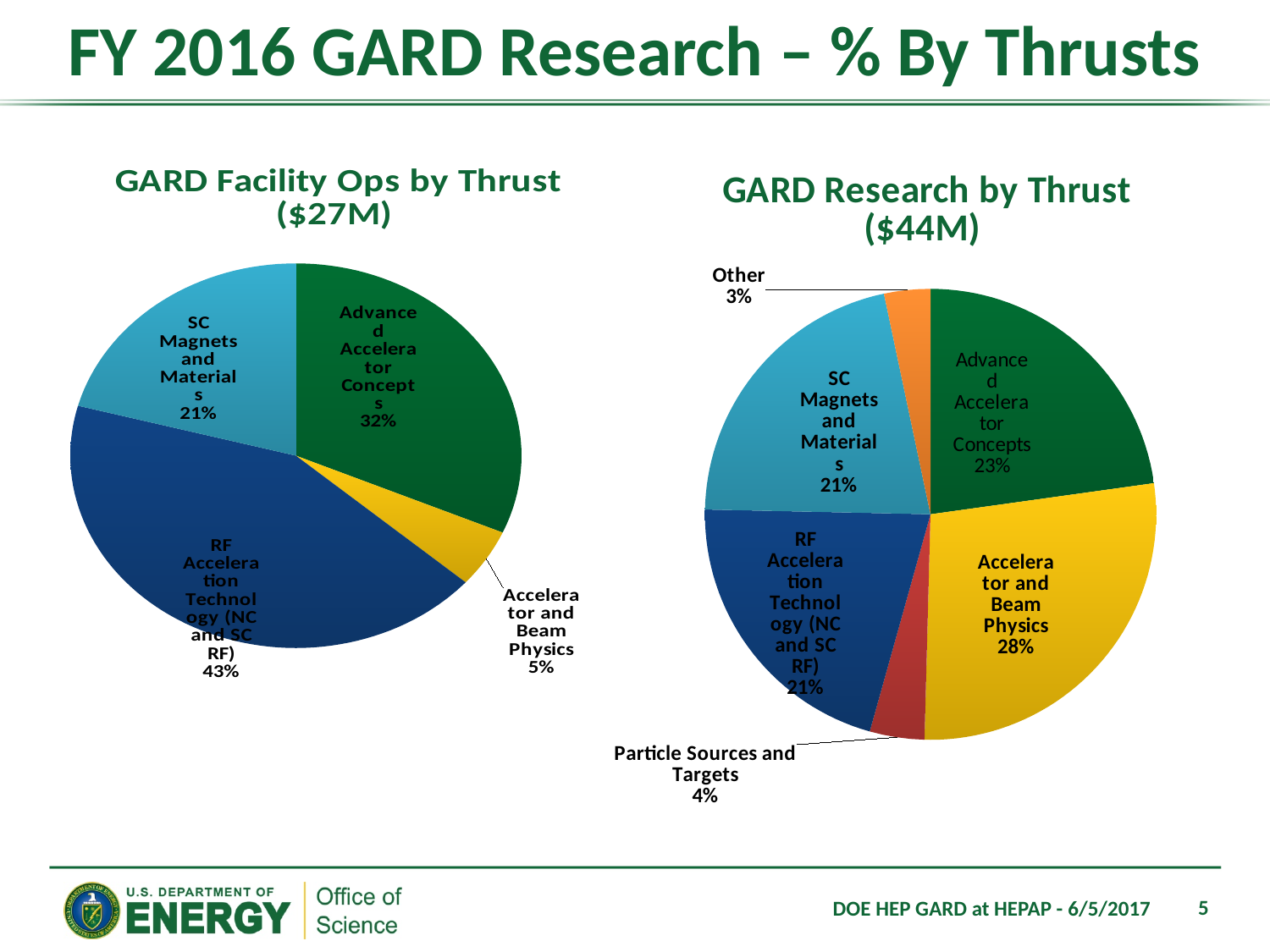
In the GARD Research by Thrust ($44M) chart, how many slices does the pie have? 6 In the GARD Research by Thrust ($44M) chart, what share does Accelerator and Beam Physics have? 28% In the GARD Research by Thrust ($44M) chart, what share does Other have? 3% In the GARD Facility Ops by Thrust ($27M) chart, which thrust has the smallest share? Accelerator and Beam Physics In the GARD Research by Thrust ($44M) chart, which thrust has the largest share? Accelerator and Beam Physics In the GARD Facility Ops by Thrust ($27M) chart, what share does RF Acceleration Technology (NC and SC RF) have? 43% What kind of chart is the GARD Facility Ops by Thrust ($27M) chart? Pie chart In the GARD Facility Ops by Thrust ($27M) chart, which thrust has the largest share? RF Acceleration Technology (NC and SC RF) In the GARD Research by Thrust ($44M) chart, what is the difference in percentage points between Accelerator and Beam Physics and Advanced Accelerator Concepts? 5 percentage points In the GARD Facility Ops by Thrust ($27M) chart, how many slices does the pie have? 4 In the GARD Facility Ops by Thrust ($27M) chart, what share does Advanced Accelerator Concepts have? 32% In the GARD Research by Thrust ($44M) chart, what share does Particle Sources and Targets have? 4%